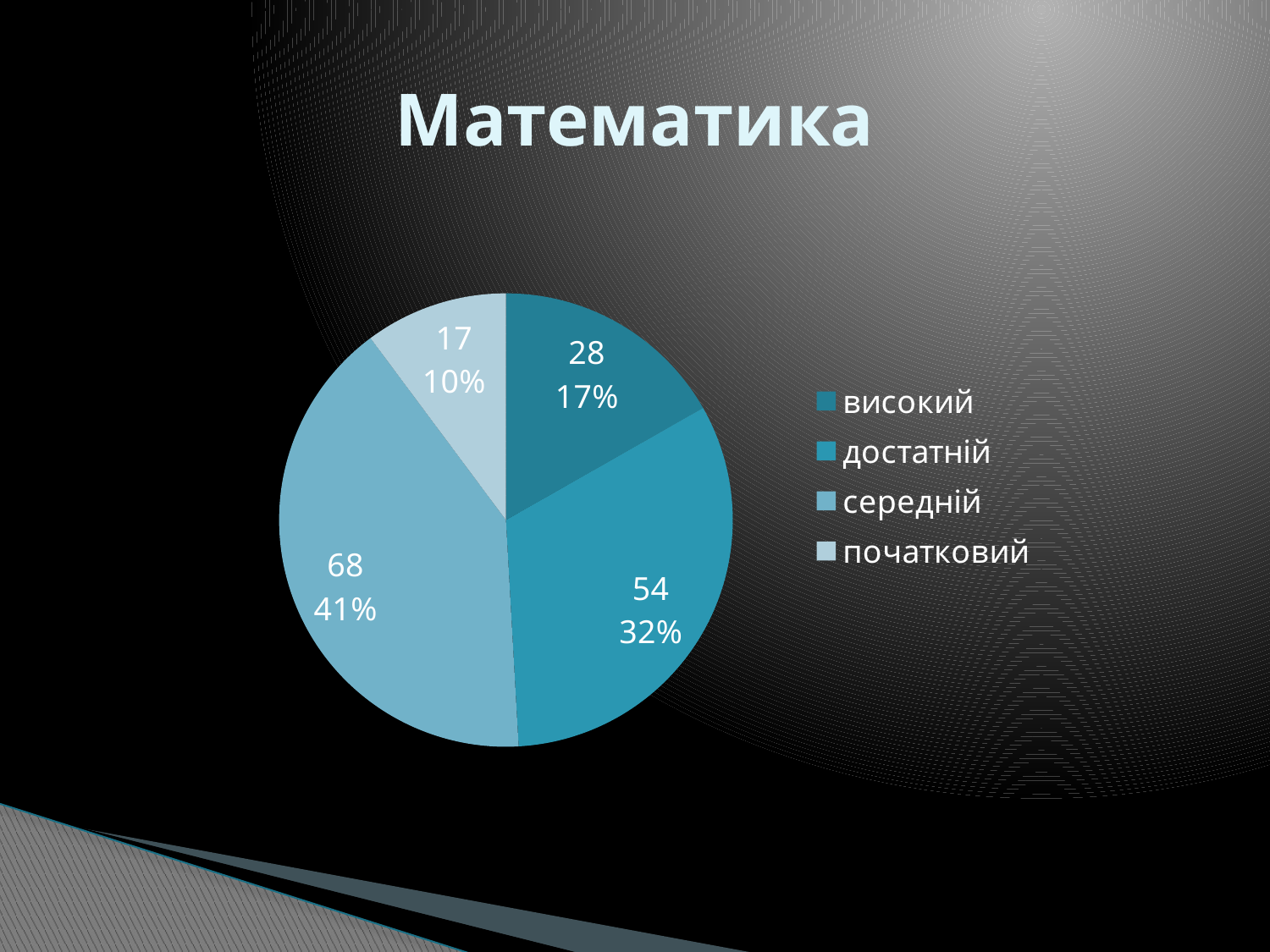
What is the difference between the values for середній and достатній? 14 What share of the pie does середній take? 41% What is the value for середній? 68 Which is larger, the value for високий or the value for достатній? достатній What kind of chart is shown on the slide? pie chart What is the value for достатній? 54 Which category has the largest slice? середній Which category has the smallest slice? початковий What is the value for початковий? 17 What share of the pie does початковий take? 10% What is the value for високий? 28 How many categories does the legend list? 4